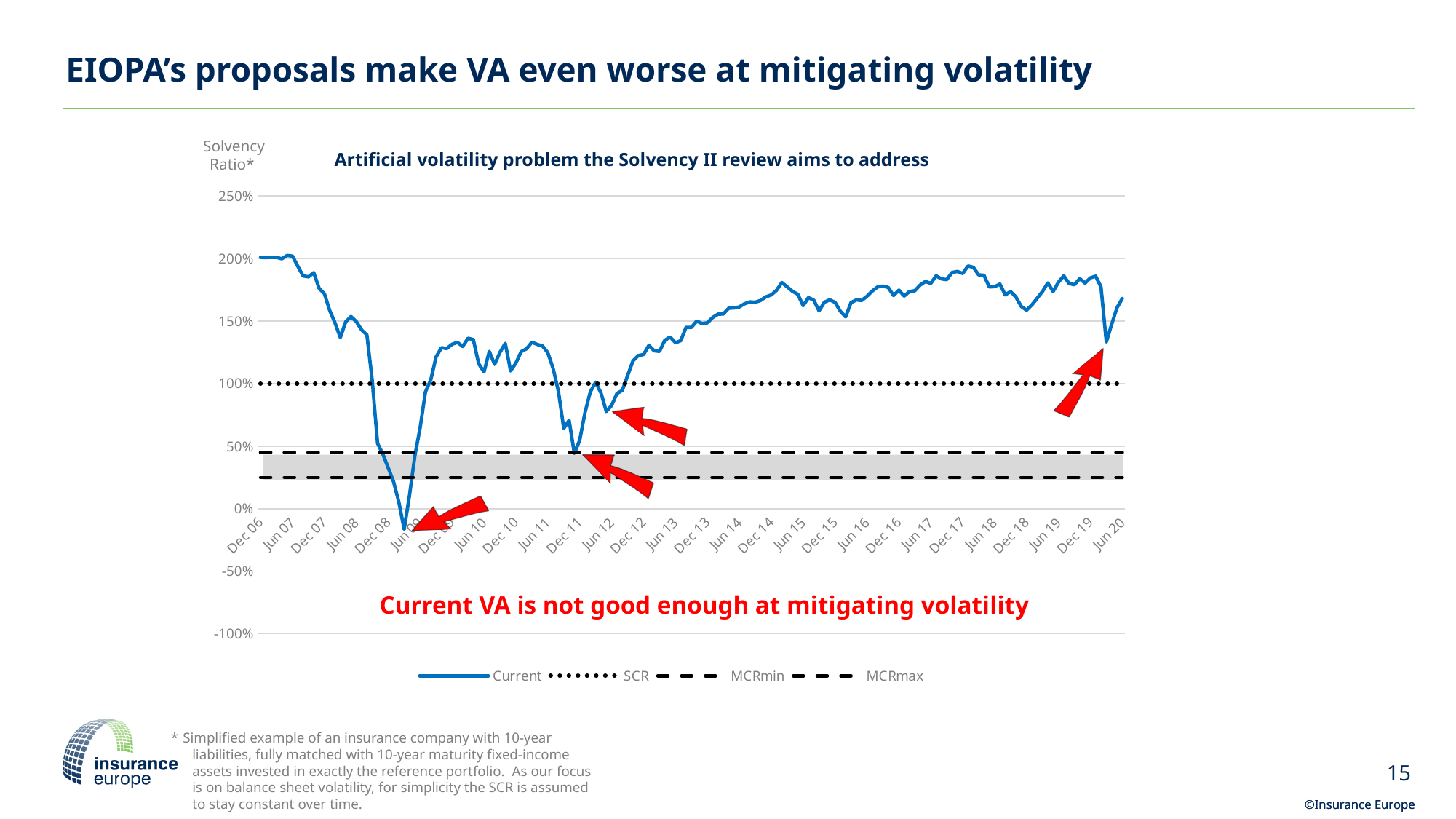
Is the Current solvency ratio at Jun 20 greater or less than 150%? greater What is the title of the chart? Artificial volatility problem the Solvency II review aims to address Which is larger, the Current solvency ratio at Jun 09 or at Jun 20? Jun 20 Is the Current solvency ratio at Jun 12 greater or less than 100%? less How many date labels are shown on the x axis? 28 Is the Current solvency ratio at Dec 08 greater or less than 100%? less Which series is drawn as a solid blue line? Current At what level does the SCR line sit on the y axis? 100% How many series does the chart legend list? 4 Does the Current solvency ratio rise or fall between Dec 12 and Dec 14? rise What kind of chart is shown on the slide? line chart